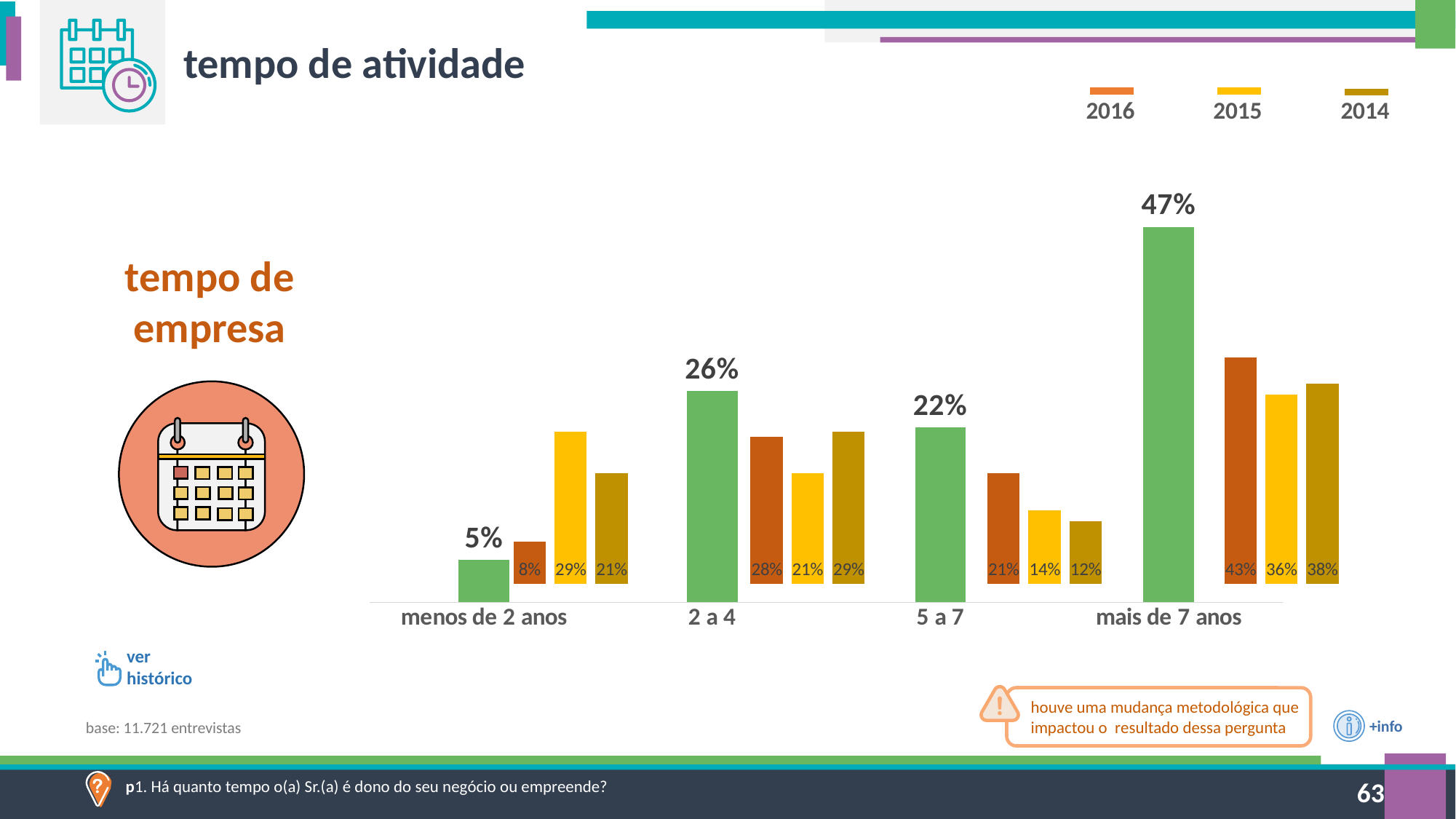
Which category has the highest green bar? mais de 7 anos Which years are listed in the chart legend? 2016, 2015, 2014 How many series does the legend list? 3 What is the 2016 value for '2 a 4'? 28% What is the 2015 value for 'menos de 2 anos'? 29% Which category has the lowest 2016 value? menos de 2 anos What is the difference between the 2016 and 2015 values for 'mais de 7 anos'? 7% How many categories are shown on the x axis of the chart? 4 What is the 2014 value for '5 a 7'? 12% What is the value of the green bar for 'mais de 7 anos'? 47% What type of chart is shown on the slide? bar chart For '5 a 7', which is larger: the 2016 value or the 2014 value? 2016